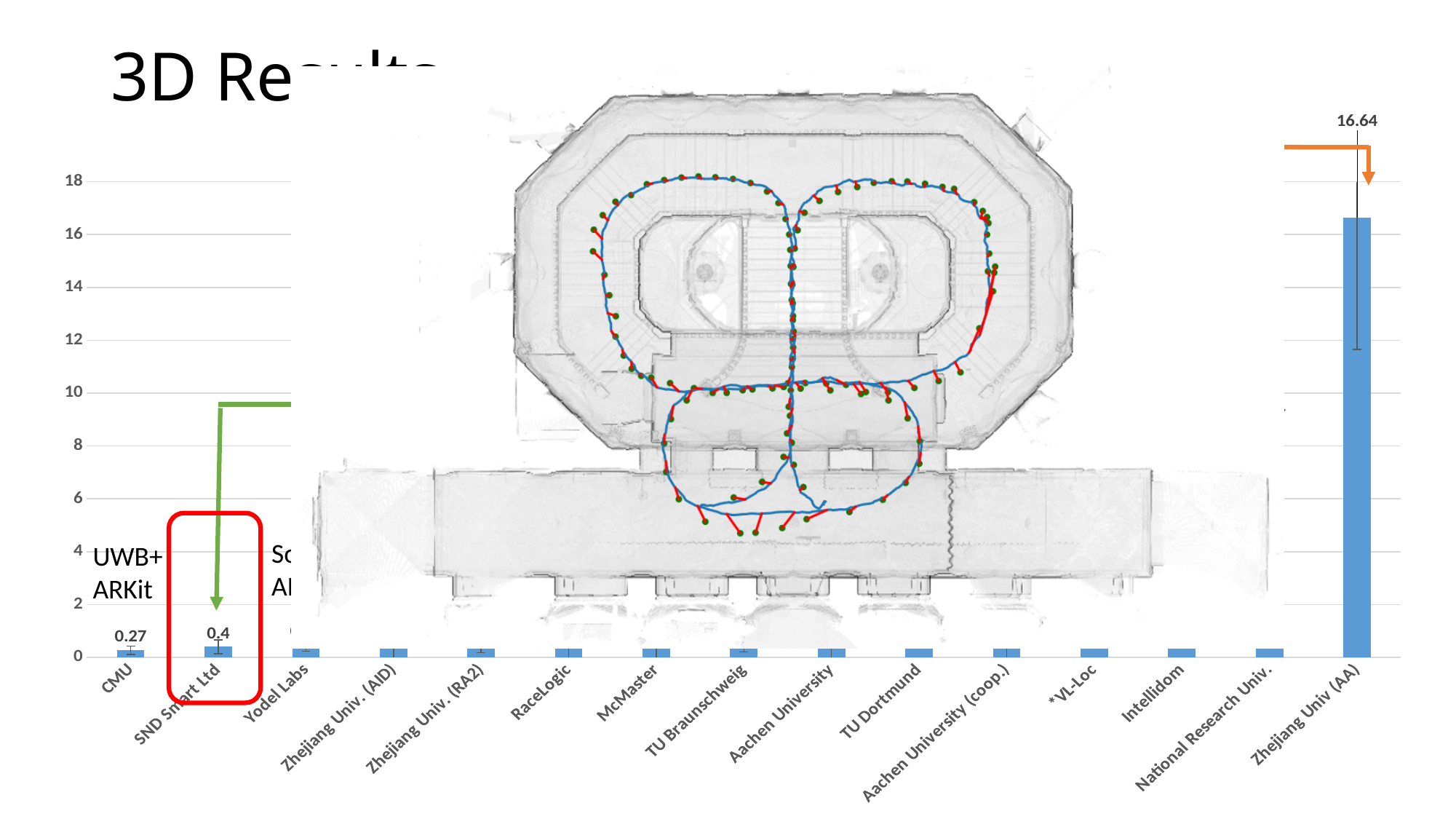
What is the difference between the values for Zhejiang Univ (AA) and CMU? 16.37 Is the value for Zhejiang Univ (AA) greater or less than 10? greater What kind of chart is shown on the slide? bar chart What is the value for SND Smart Ltd? 0.4 Is the value for TU Dortmund greater or less than 2? less What is the value for Zhejiang Univ (AA)? 16.64 What is the value for CMU? 0.27 Which category has the highest value? Zhejiang Univ (AA) How many categories are shown on the x axis? 15 What is the difference between the values for SND Smart Ltd and CMU? 0.13 Which category is highlighted with a red rectangle? SND Smart Ltd Which is larger, the value for CMU or the value for SND Smart Ltd? SND Smart Ltd